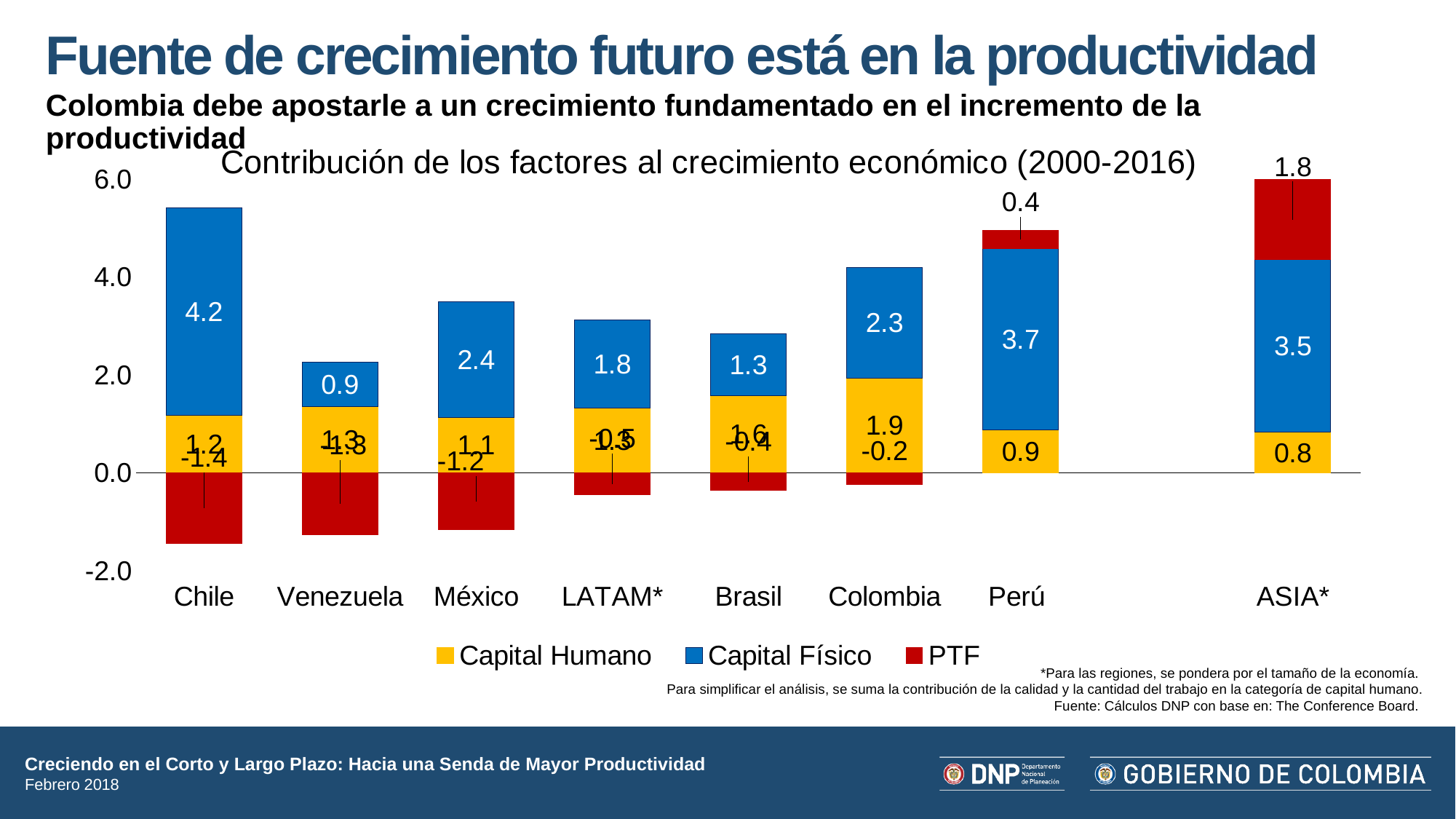
What is the total of the stacked bar for Perú? 5.0 What is the PTF value for ASIA*? 1.8 What is the PTF value for Perú? 0.4 What is the Capital Físico value for Chile? 4.2 Which country or region has the lowest Capital Físico value? Venezuela Which country or region has the highest Capital Físico value? Chile What is the Capital Humano value for Colombia? 1.9 How many countries or regions are shown on the x axis? 8 How many series does the legend list? 3 Is the top of the stacked bar for Perú greater or less than 4.0? greater What is the difference between the Capital Físico values for Chile and Perú? 0.5 Which has a larger Capital Físico value, Perú or ASIA*? Perú